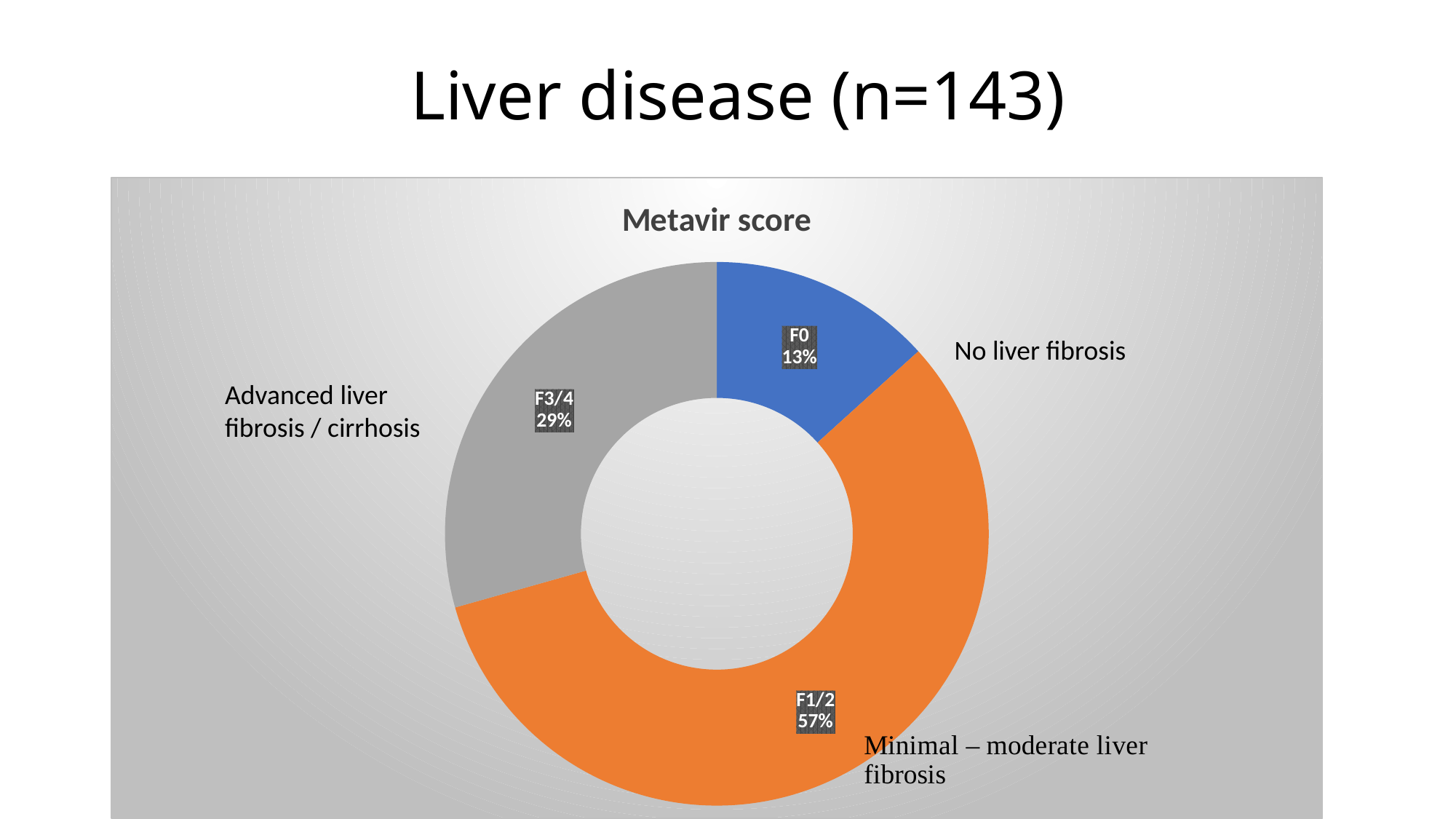
Which Metavir score category has the smallest share of the chart? F0 What percentage of the Metavir score chart is F0? 13% How many categories are shown in the Metavir score chart? 3 Which slice is larger, F0 or F3/4? F3/4 Which Metavir score category is labelled as 'No liver fibrosis'? F0 What percentage of the Metavir score chart is F1/2? 57% What kind of chart is shown on the slide? Doughnut chart What is the difference in percentage points between the F1/2 and F3/4 slices? 28 What is the difference in percentage points between the F3/4 and F0 slices? 16 What percentage of the Metavir score chart is F3/4? 29% Which Metavir score category has the largest share of the chart? F1/2 What is the title of the chart? Metavir score